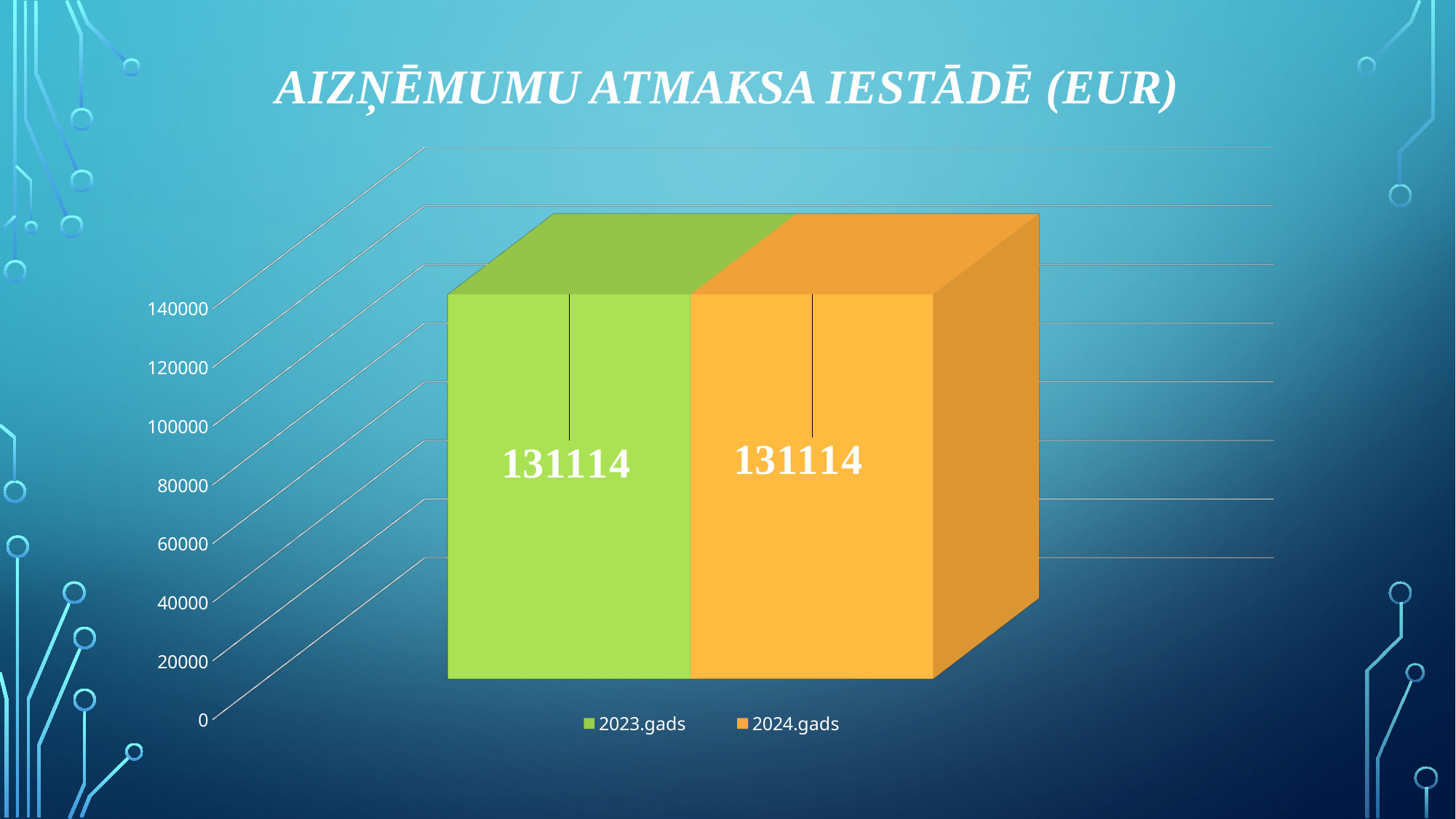
Is the value for 2023.gads greater or less than 140000? less What kind of chart is shown on the slide? bar chart Are the values for 2023.gads and 2024.gads equal? yes What is the value for 2024.gads? 131114 What is the title of the chart? AIZŅĒMUMU ATMAKSA IESTĀDĒ (EUR) What is the difference between the values for 2023.gads and 2024.gads? 0 Which colour represents 2024.gads in the legend? orange What is the value for 2023.gads? 131114 Is the value for 2024.gads greater or less than 120000? greater How many series does the legend list? 2 What is the highest value shown on the vertical axis? 140000